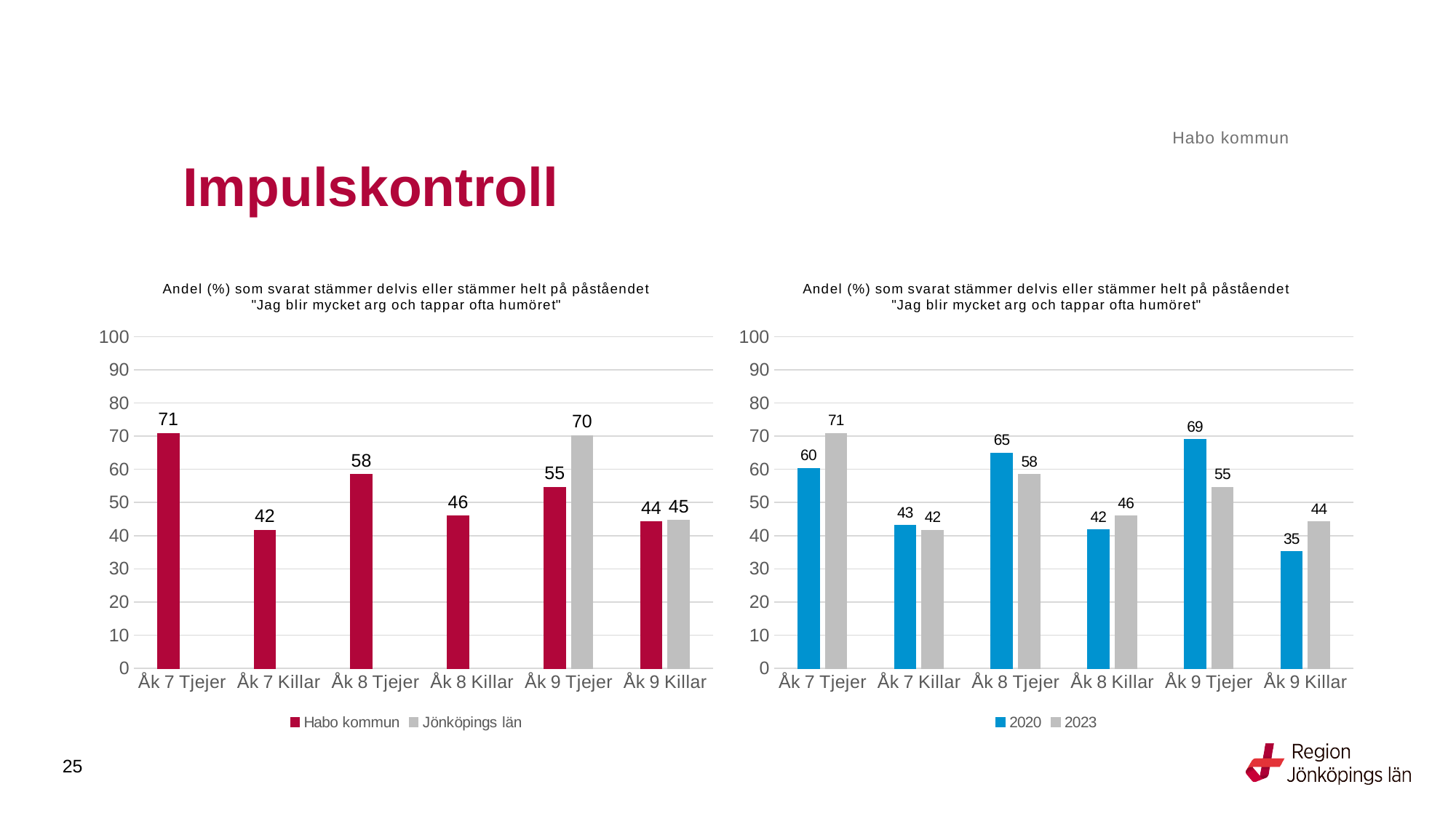
In the right chart, which category has the highest 2023 value? Åk 7 Tjejer In the right chart, which category has the lowest 2020 value? Åk 9 Killar In the right chart, what is the 2023 value for Åk 8 Killar? 46 In the left chart, how many series does the legend list? 2 In the left chart, what is the value for Jönköpings län for Åk 9 Tjejer? 70 In the left chart, which category has the lowest Habo kommun value? Åk 7 Killar In the left chart, what is the difference between the Habo kommun values for Åk 8 Tjejer and Åk 8 Killar? 12 In the right chart, which is larger for Åk 8 Tjejer, the 2020 value or the 2023 value? 2020 In the right chart, what is the 2020 value for Åk 9 Tjejer? 69 In the right chart, what is the difference between the 2020 and 2023 values for Åk 7 Tjejer? 11 What type of chart is the right chart? Bar chart In the left chart, what is the value for Habo kommun for Åk 7 Tjejer? 71